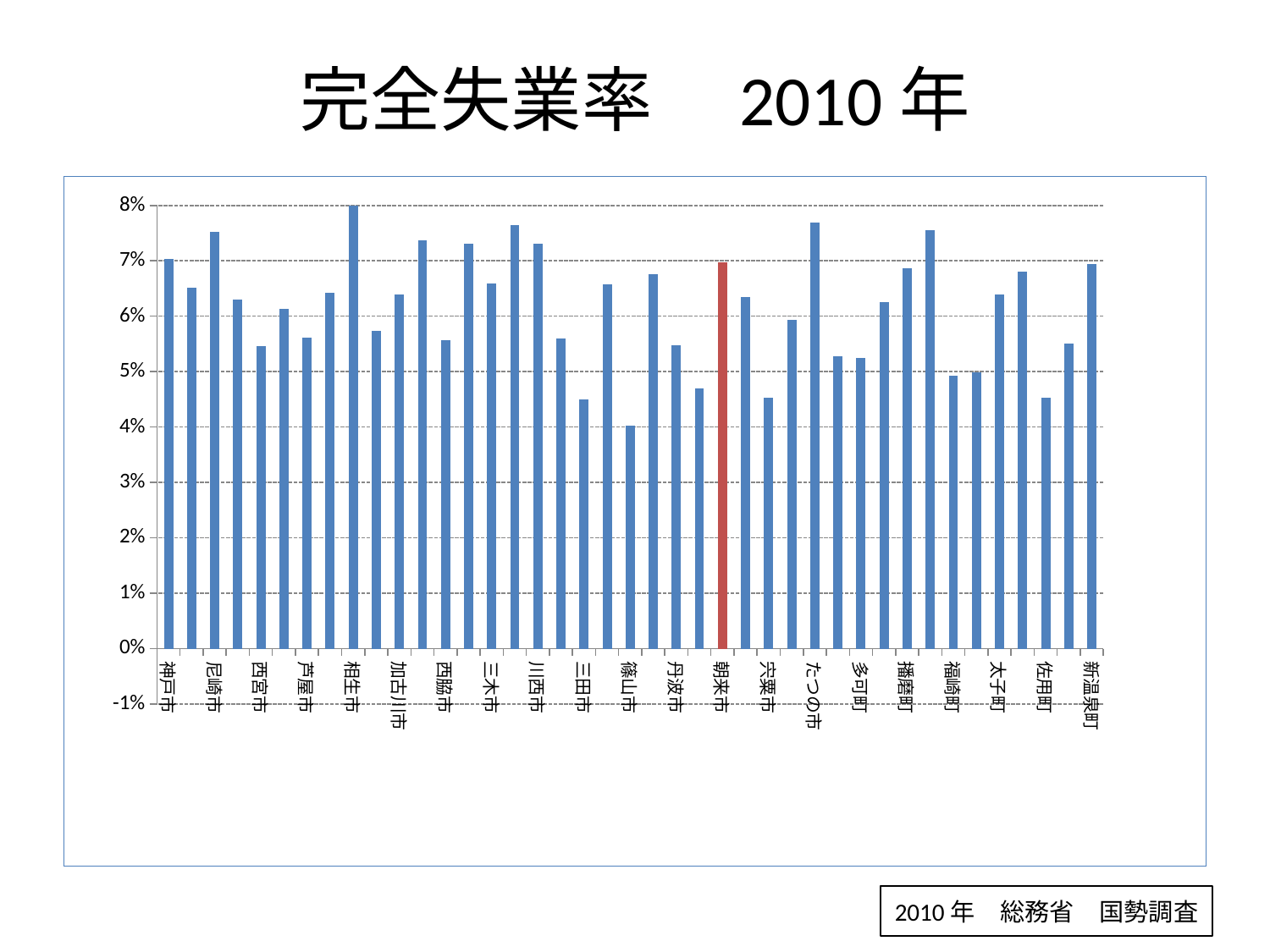
Which has the higher unemployment rate, 川西市 or 三田市? 川西市 Which municipality's bar is coloured red instead of blue? 朝来市 Is the value for 西宮市 greater or less than 6%? less Is the value for 三田市 greater or less than 5%? less What is the title of the slide's chart? 完全失業率 2010年 What kind of chart is shown on the slide? bar chart Which municipality has the highest unemployment rate in the chart? 相生市 Is the value for 神戸市 greater or less than 6%? greater Which labeled municipality has the lowest unemployment rate in the chart? 篠山市 Which has the higher unemployment rate, 尼崎市 or 西宮市? 尼崎市